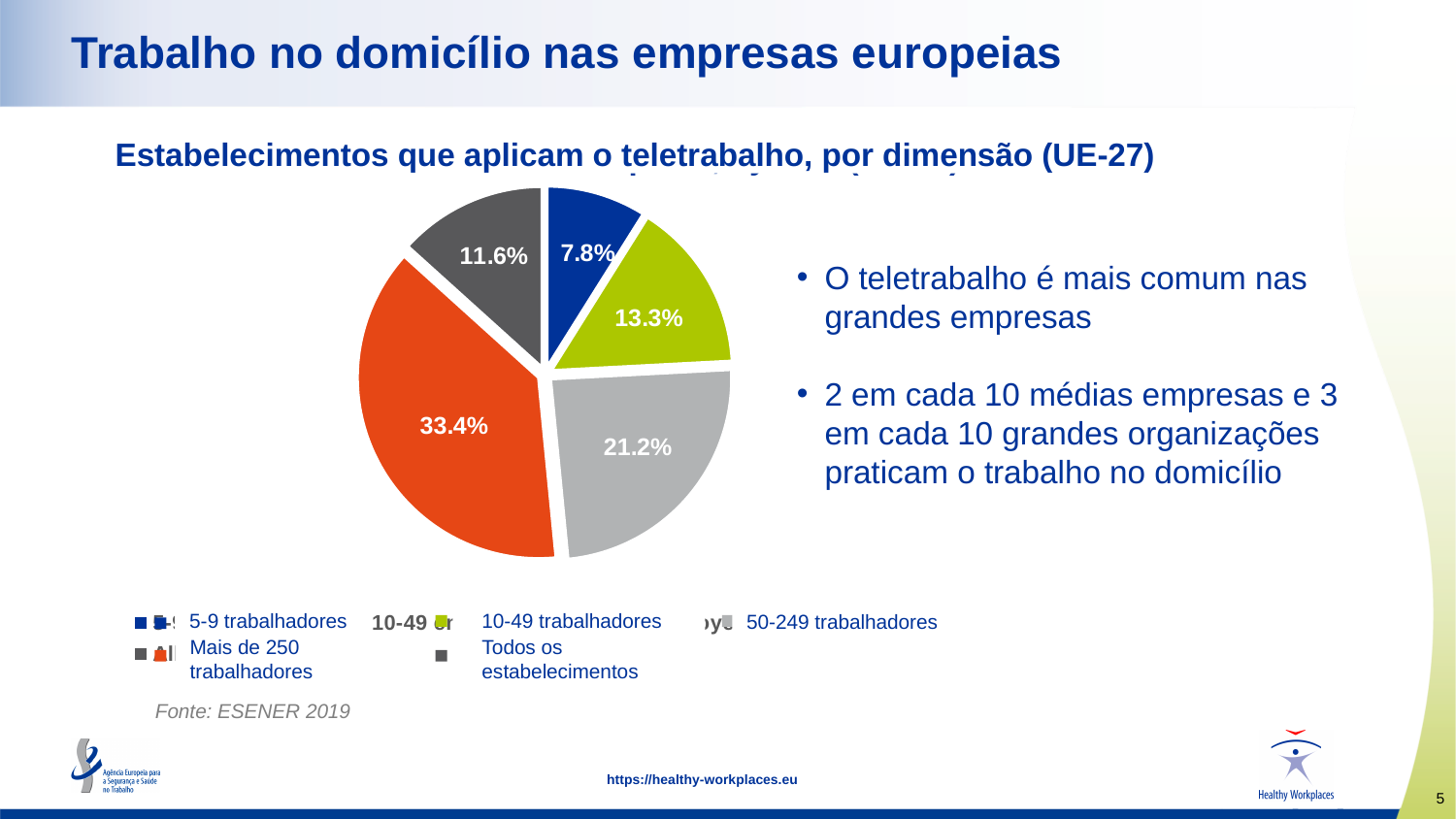
Which category has the largest slice in the pie chart? Mais de 250 trabalhadores How many slices does the pie chart have? 5 What is the title of the chart? Estabelecimentos que aplicam o teletrabalho, por dimensão (UE-27) What is the difference between the values for 'Mais de 250 trabalhadores' and '50-249 trabalhadores'? 12.2% What is the value shown for the 'Todos os estabelecimentos' slice? 11.6% What is the value shown for the '5-9 trabalhadores' slice? 7.8% What is the value shown for the '10-49 trabalhadores' slice? 13.3% What type of chart is shown on the slide? Pie chart What is the value shown for the 'Mais de 250 trabalhadores' slice? 33.4% Which is larger, the value for '10-49 trabalhadores' or the value for 'Todos os estabelecimentos'? 10-49 trabalhadores Which category has the smallest slice in the pie chart? 5-9 trabalhadores What is the value shown for the '50-249 trabalhadores' slice? 21.2%